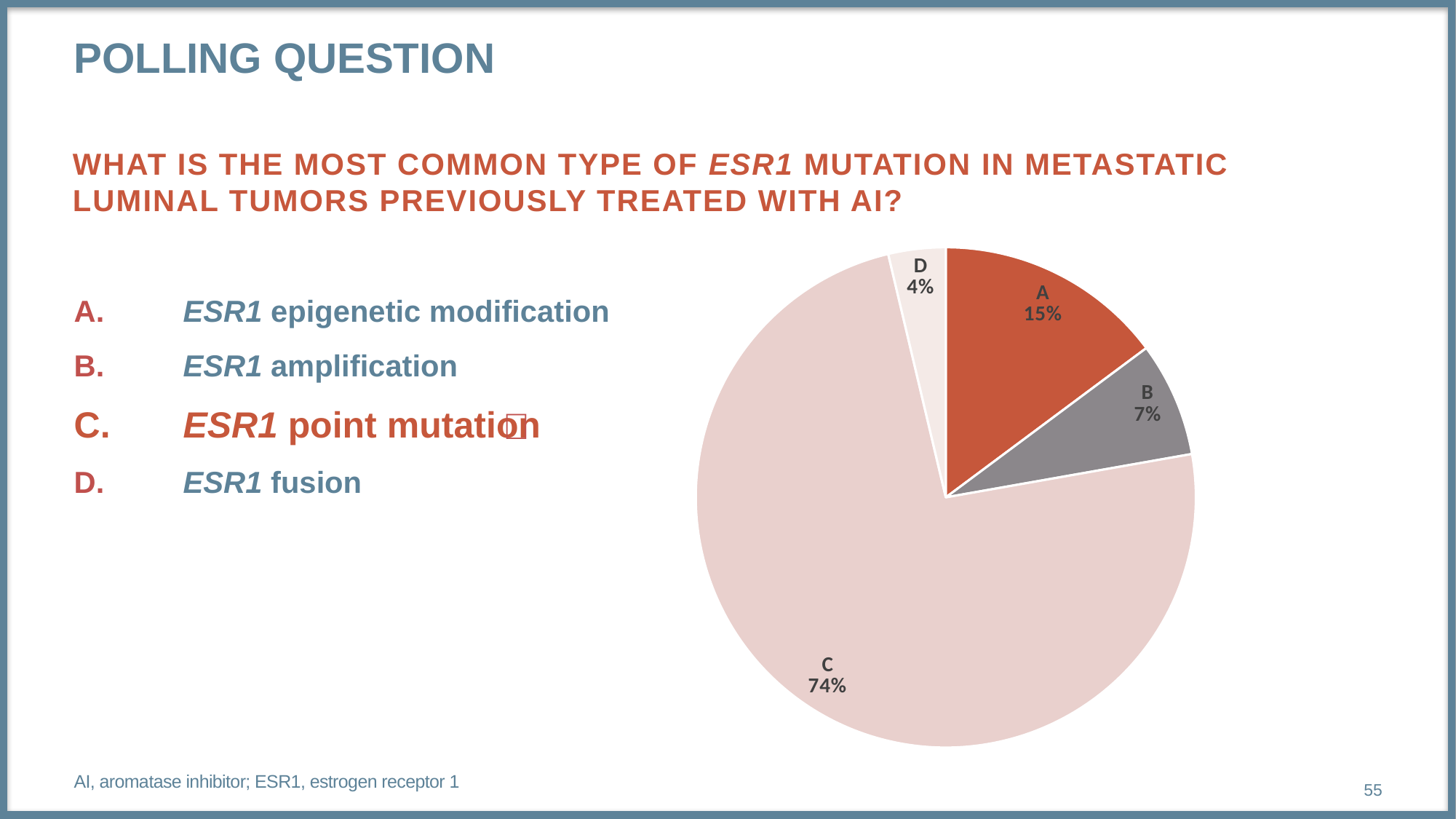
How many slices does the pie chart have? 4 Which slice of the pie chart is the smallest? D Which is larger in the pie chart, slice A or slice D? A What percentage is shown for slice A in the pie chart? 15% What is the combined percentage of slices A and B in the pie chart? 22% What kind of chart is shown on the slide? pie chart What percentage is shown for slice D in the pie chart? 4% Which slice of the pie chart is the largest? C What percentage is shown for slice B in the pie chart? 7% What is the difference in percentage points between slice A and slice B in the pie chart? 8 What percentage is shown for slice C in the pie chart? 74% Which slice of the pie chart is coloured dark orange-red? A